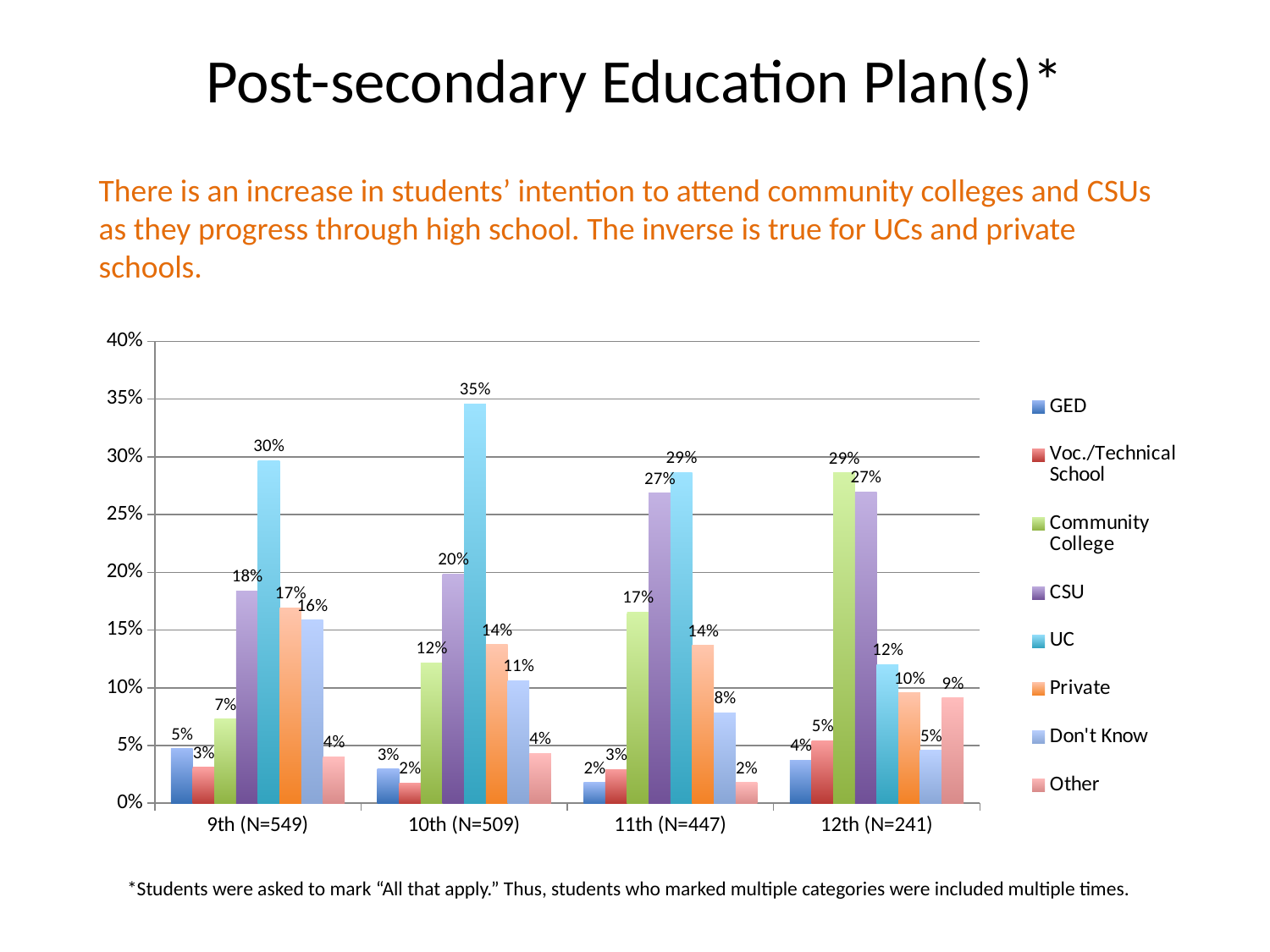
What percentage of 10th graders (N=509) plan to attend a UC? 35% What is the Community College value for 12th graders (N=241)? 29% Which grade has the highest UC value? 10th (N=509) By how many percentage points does the CSU value for 12th graders exceed the CSU value for 9th graders? 9 percentage points What is the Don't Know value for 9th graders (N=549)? 16% Does the Community College value rise or fall from 9th grade to 12th grade? Rises How many series does the legend list? 8 Does the UC value rise or fall from 10th grade to 12th grade? Falls For 11th graders (N=447), which is larger: the CSU value or the UC value? UC Which grade has the lowest Community College value? 9th (N=549) How many grade-level categories are shown on the x axis? 4 What kind of chart is shown on the slide? Bar chart